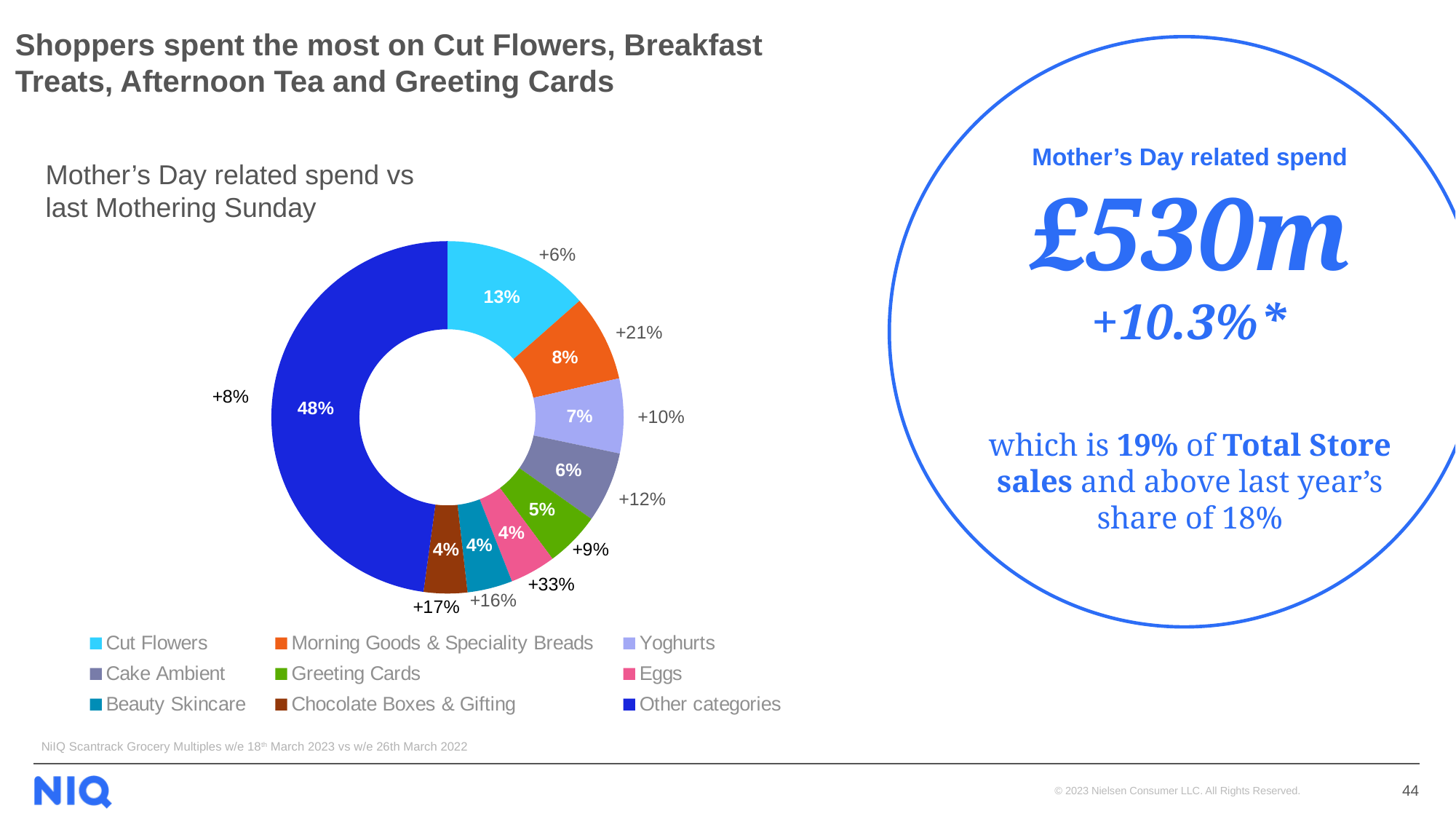
What share of Mother's Day related spend does Other categories account for? 48% What share of Mother's Day related spend does Yoghurts account for? 7% What share of Mother's Day related spend does Cut Flowers account for? 13% What is the growth vs last Mothering Sunday shown next to the Morning Goods & Speciality Breads slice? +21% What is the growth vs last Mothering Sunday shown next to the Eggs slice? +33% Which category has the largest share of the doughnut chart? Other categories What is the title of the doughnut chart? Mother's Day related spend vs last Mothering Sunday What kind of chart is shown on the slide? Doughnut (pie) chart Which category shows the lowest growth vs last Mothering Sunday? Cut Flowers (+6%) What is the difference in share between Cut Flowers and Greeting Cards? 8 percentage points How many categories does the legend of the doughnut chart list? 9 Which has a larger share of spend, Morning Goods & Speciality Breads or Cake Ambient? Morning Goods & Speciality Breads